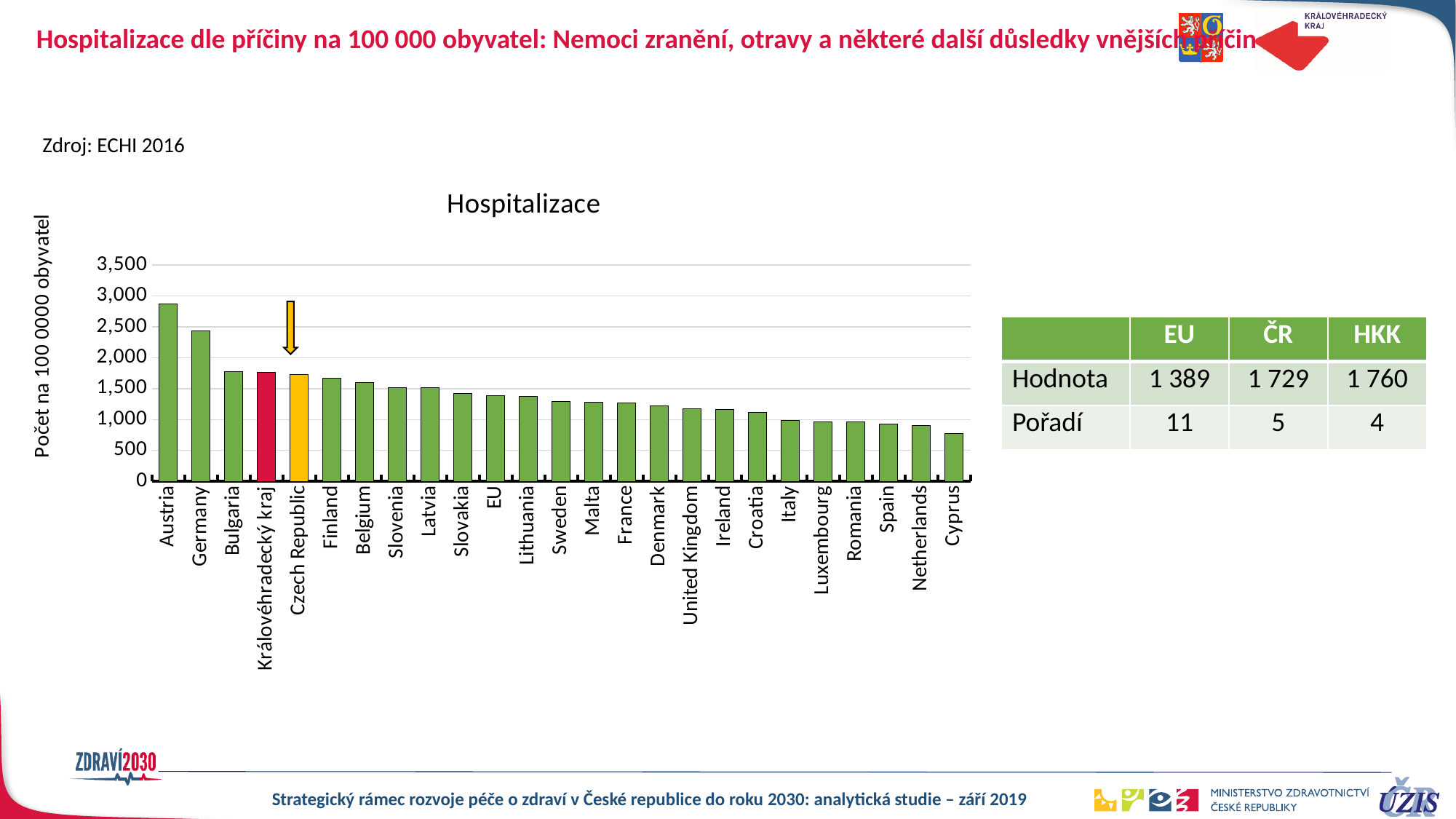
Which has a higher hospitalization rate, Germany or Bulgaria? Germany What type of chart is shown on the slide? bar chart Is the value for Cyprus greater or less than 1,000? less Which country or region has the highest hospitalization rate in the chart? Austria What is the difference between the HKK value and the EU value shown in the table? 371 Do the bar values rise or fall from left to right along the x axis? fall According to the table, what is the hospitalization value for HKK? 1 760 How many categories (bars) are shown in the chart? 25 According to the table, what is the hospitalization value for ČR? 1 729 According to the table, what is the hospitalization value for the EU? 1 389 Is the value for Austria greater or less than 2,500? greater Which country has the lowest hospitalization rate in the chart? Cyprus